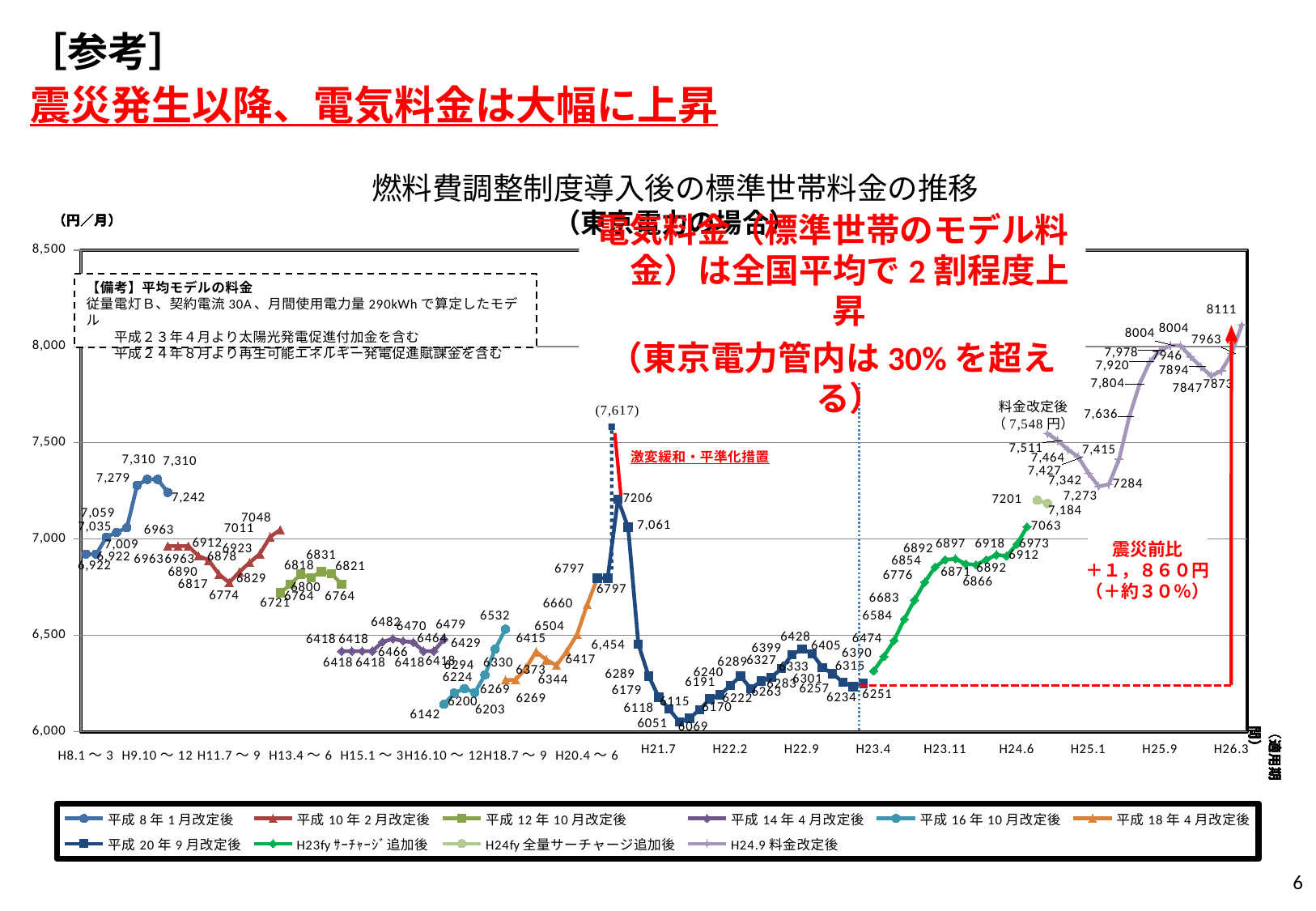
What is the highest data label shown on the chart? 8111 What kind of chart is shown on the slide? line chart What is the last series listed in the legend? H24.9料金改定後 What unit is shown on the vertical axis? 円／月 What value is shown in parentheses at the peak of the 平成20年9月改定後 series, next to the 激変緩和・平準化措置 note? (7,617) Which is larger: the peak of the 平成8年1月改定後 series (7,310) or the peak of the 平成10年2月改定後 series (7048)? 7,310 Is the final value at H26.3 greater or less than 8,000? greater What value is given in the 料金改定後 annotation? 7,548円 What is the value of the last point on the chart, at H26.3? 8111 How many series does the legend list? 10 What is the lowest data label shown on the chart? 6051 What is the difference between the final value 8111 and the value 6251 at the start of the H23fy サーチャージ追加後 series? 1860